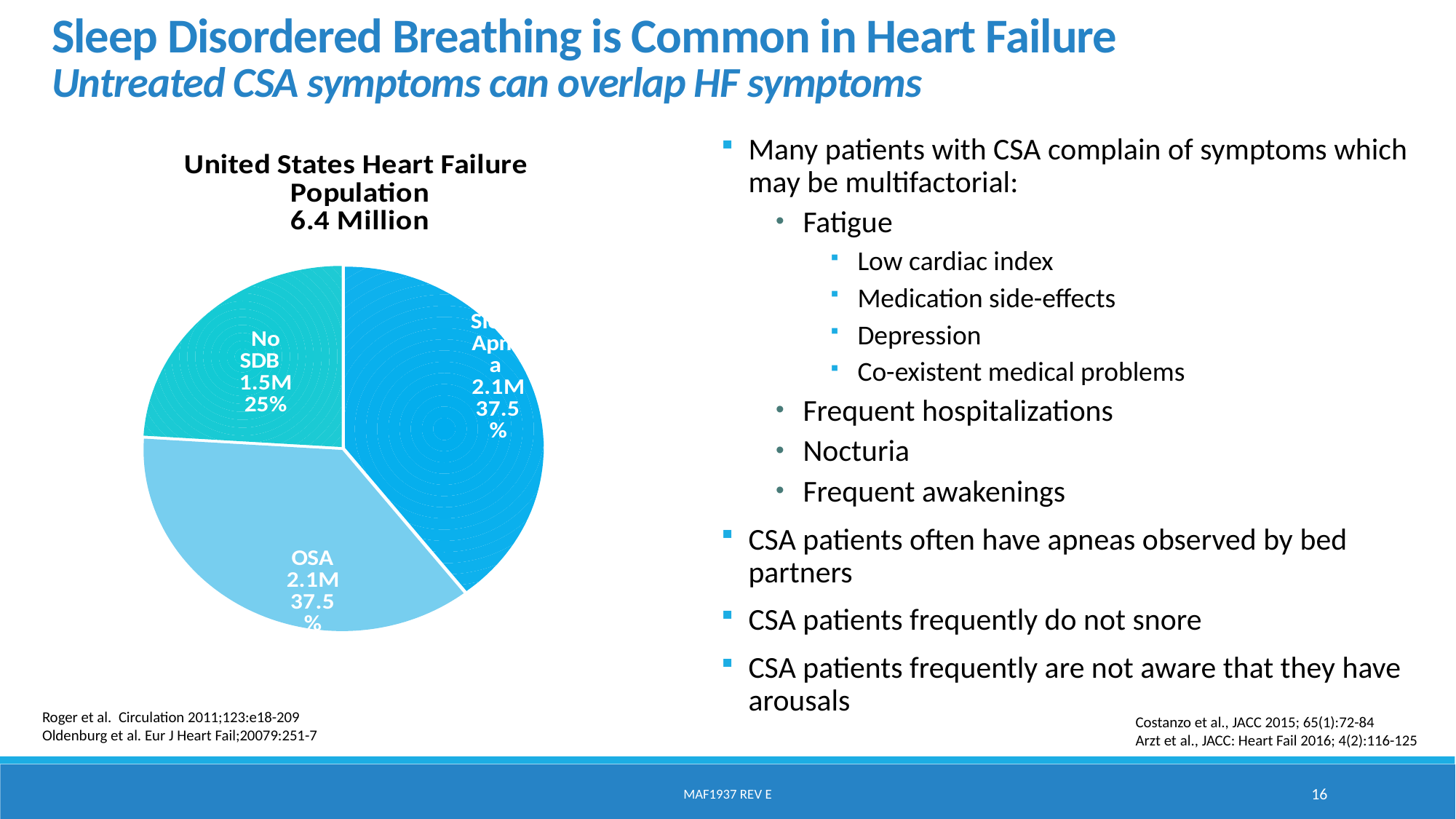
By how many percentage points does the OSA share exceed the No SDB share? 12.5% What is the title of the pie chart? United States Heart Failure Population 6.4 Million How many slices does the pie chart have? 3 What share of the pie does the OSA slice represent? 37.5% What share of the pie does the No SDB slice represent? 25% Which slice of the pie chart is the smallest? No SDB What is the value shown for the OSA slice of the pie chart? 2.1M What share of the pie does the dark blue slice on the right side of the chart represent? 37.5% Which is larger in the pie chart, OSA or No SDB? OSA What type of chart is shown on the slide? pie chart What is the difference in millions between the OSA slice and the No SDB slice? 0.6M What is the value shown for the No SDB slice of the pie chart? 1.5M